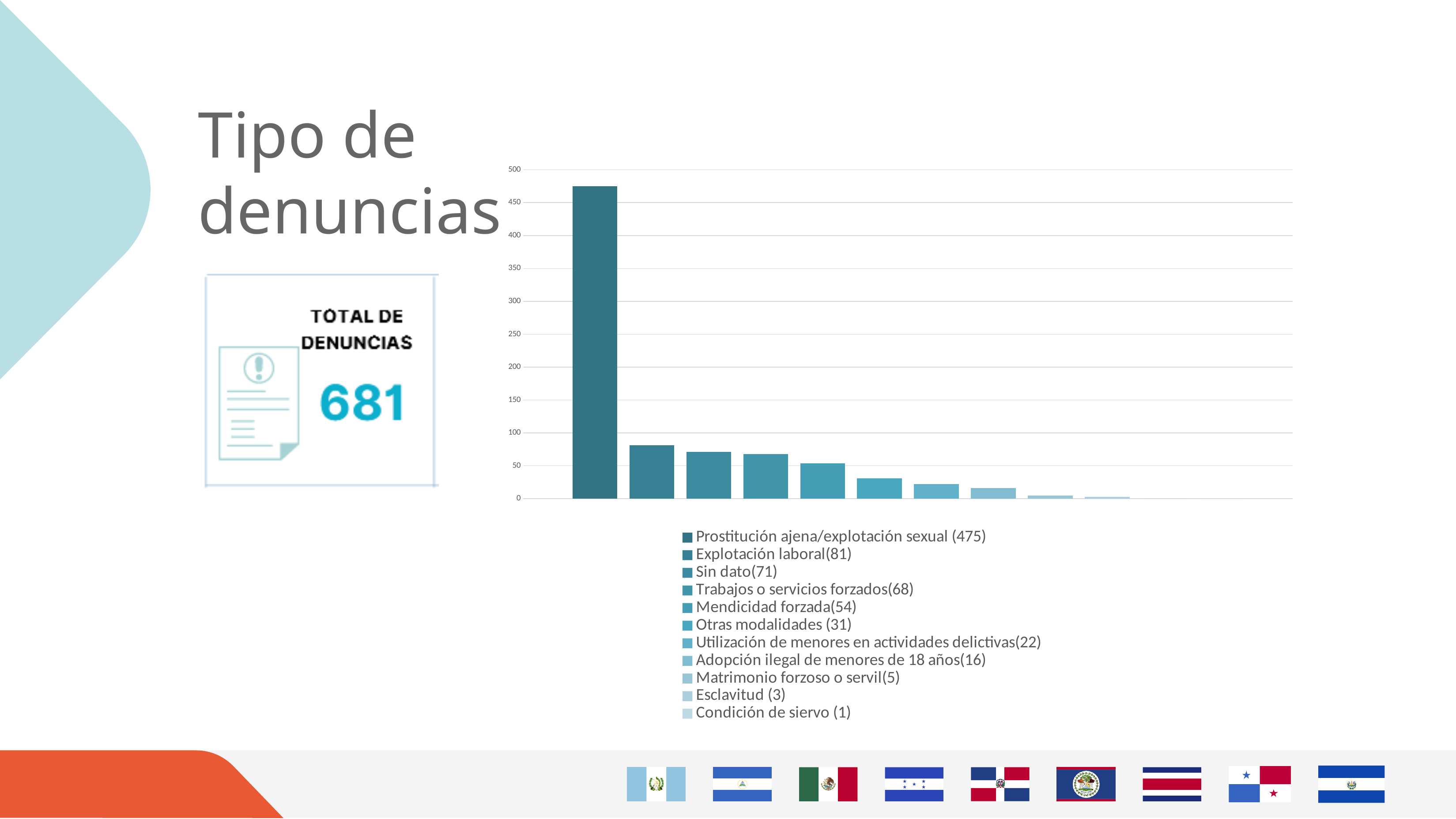
Do the bar values rise or fall from left to right along the x axis? fall Which category has the highest value? Prostitución ajena/explotación sexual What kind of chart is shown on the slide? bar chart What is the value for Explotación laboral? 81 Which category has the lowest value? Condición de siervo What is the value for Prostitución ajena/explotación sexual? 475 What is the value for Mendicidad forzada? 54 How many entries does the legend list? 11 What is the value for Utilización de menores en actividades delictivas? 22 Which is larger, the value for Trabajos o servicios forzados or the value for Otras modalidades? Trabajos o servicios forzados What is the difference between the values for Explotación laboral and Sin dato? 10